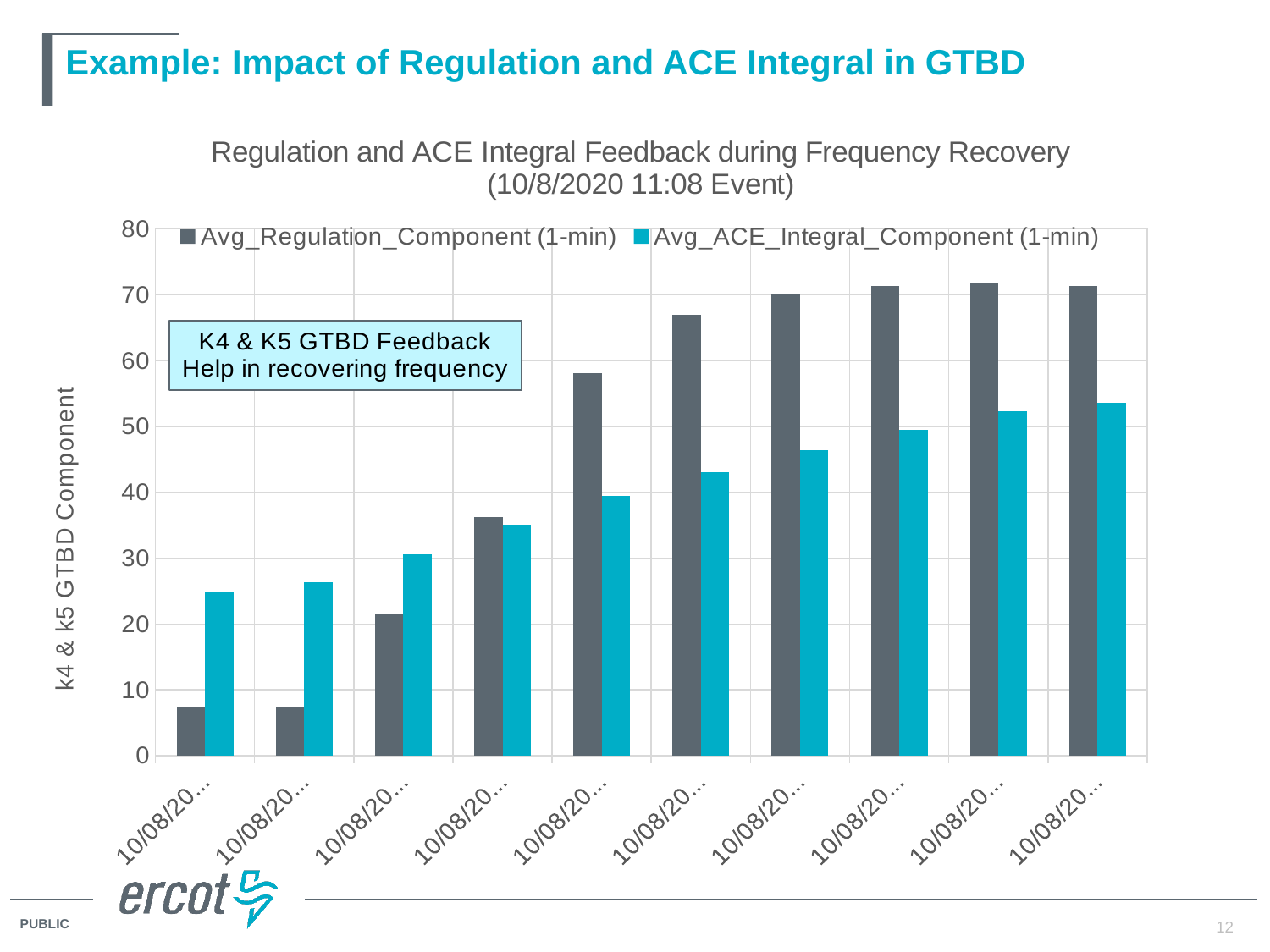
In the last (rightmost) group, which series has the larger value, Avg_Regulation_Component (1-min) or Avg_ACE_Integral_Component (1-min)? Avg_Regulation_Component (1-min) Is the Avg_Regulation_Component (1-min) value for the fifth group from the left greater or less than 50? greater Do the Avg_ACE_Integral_Component (1-min) values rise or fall from left to right along the x axis? rise How many series does the legend list? 2 Is the Avg_ACE_Integral_Component (1-min) value for the last (rightmost) group greater or less than 50? greater What is the title of the chart? Regulation and ACE Integral Feedback during Frequency Recovery (10/8/2020 11:08 Event) What is the y-axis label of the chart? k4 & k5 GTBD Component Is the Avg_Regulation_Component (1-min) value for the first (leftmost) group greater or less than 10? less How many groups of bars (categories) are plotted along the x axis? 10 In the first (leftmost) group, which series has the larger value, Avg_Regulation_Component (1-min) or Avg_ACE_Integral_Component (1-min)? Avg_ACE_Integral_Component (1-min) What kind of chart is shown on the slide? bar chart